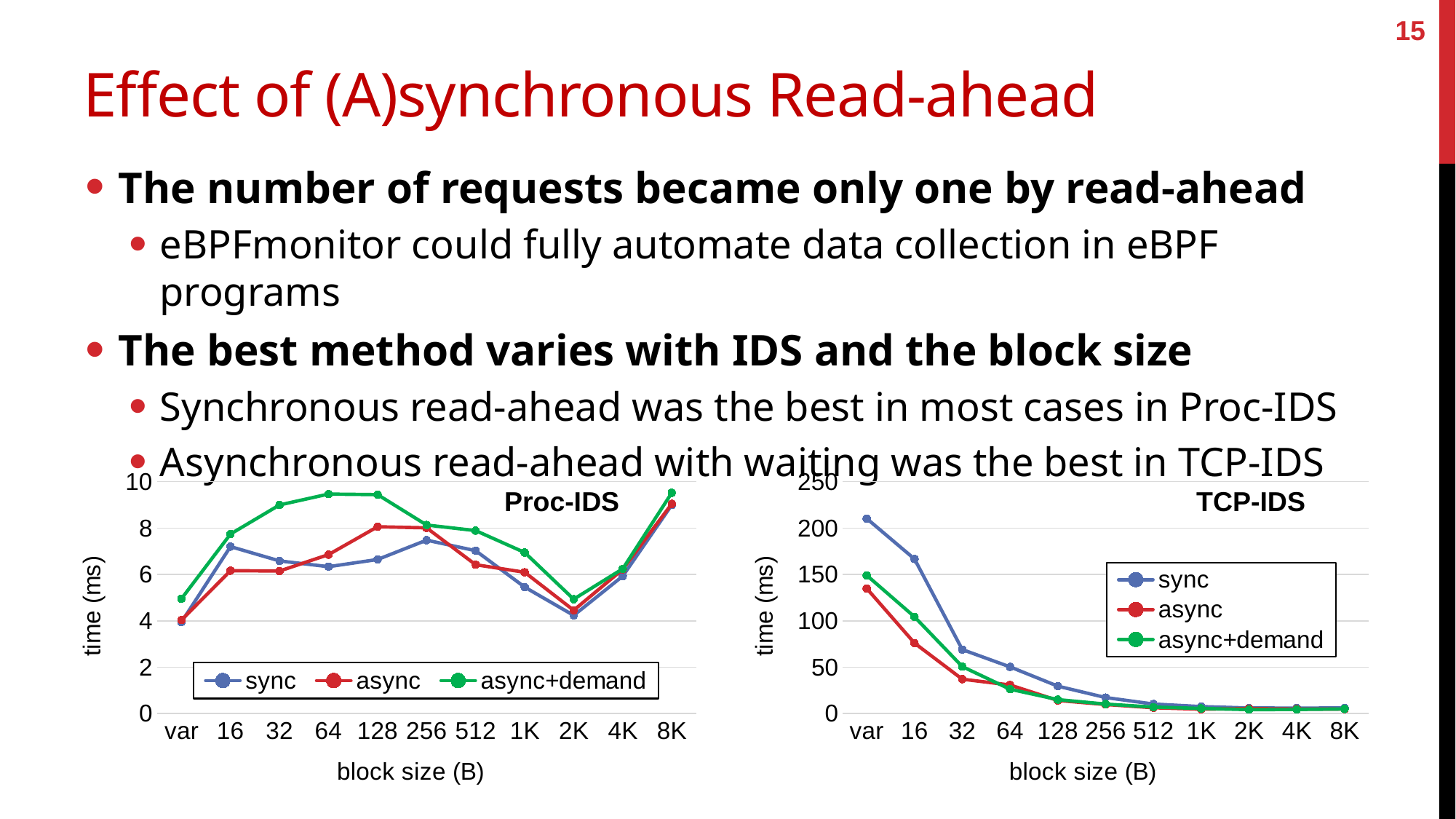
In the TCP-IDS chart, which series has the lowest value at block size var? async How many block size categories are shown on the x axis of the Proc-IDS chart? 11 In the TCP-IDS chart, is the value for sync at block size var greater or less than 200? greater In the Proc-IDS chart, which series has the highest value at block size 64? async+demand In the Proc-IDS chart, is the value for sync at block size 2K greater or less than 6? less In the Proc-IDS chart, is the value for async+demand at block size 64 greater or less than 8? greater How many series does the legend of the TCP-IDS chart list? 3 In the TCP-IDS chart, which series has the highest value at block size var? sync What kind of chart is the Proc-IDS chart? line chart In the TCP-IDS chart, does the sync series generally rise or fall from var to 8K? fall In the Proc-IDS chart, at block size 128, which is larger: sync or async? async